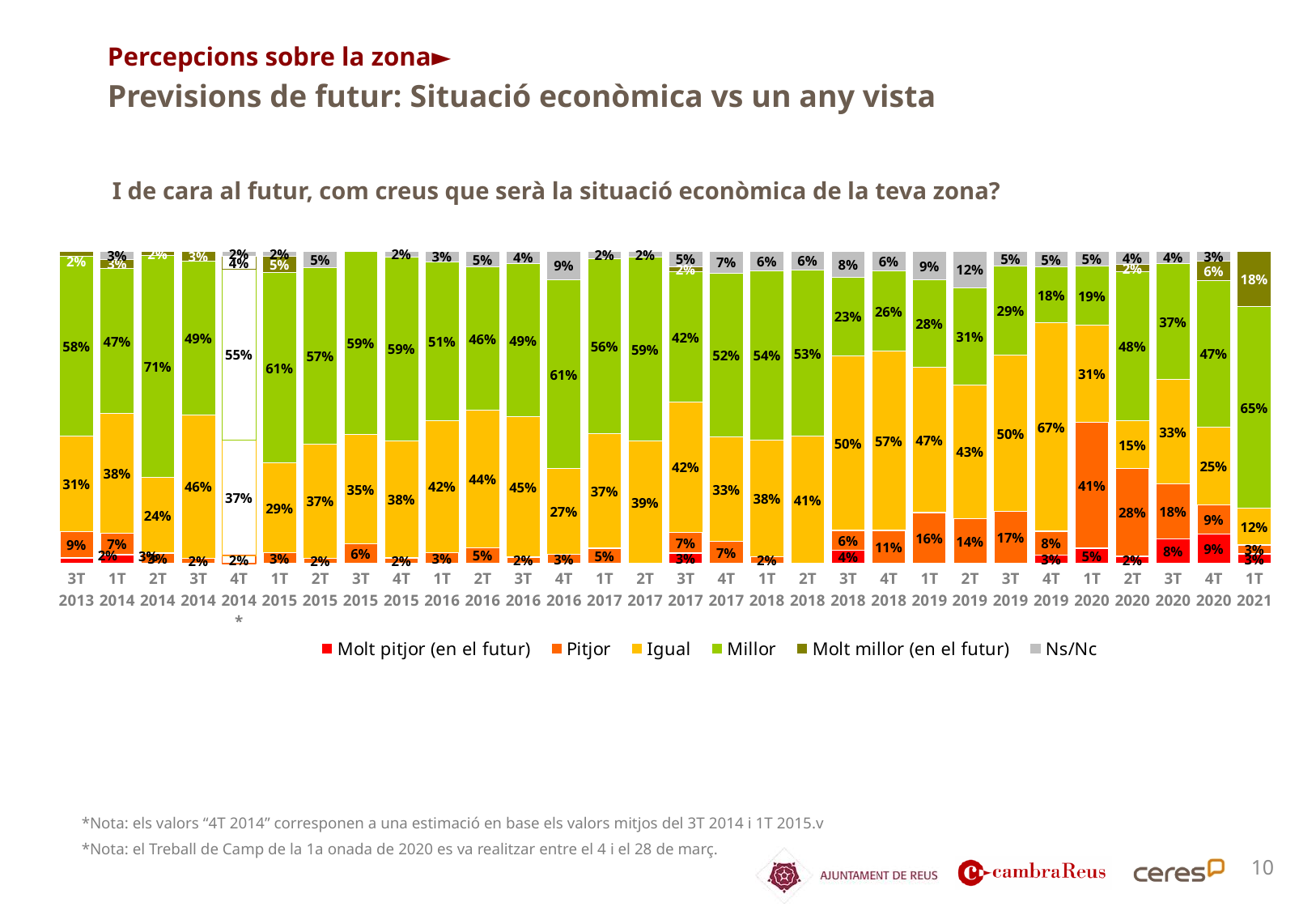
In which quarter is the Millor share highest? 2T 2014 In which quarter is the Pitjor share highest? 1T 2020 What is the value for Molt millor (en el futur) in 1T 2021? 18% What is the value for Igual in 4T 2019? 67% How many quarters (bars) are plotted on the chart? 30 What is the value for Ns/Nc in 2T 2019? 12% Which quarter has the larger Igual value, 4T 2019 or 1T 2020? 4T 2019 What kind of chart is shown on the slide? Stacked bar chart What is the value for Millor in 1T 2021? 65% What is the difference in percentage points between the Millor value in 1T 2021 and in 4T 2020? 18 How many series does the legend list? 6 What is the value for Pitjor in 1T 2020? 41%